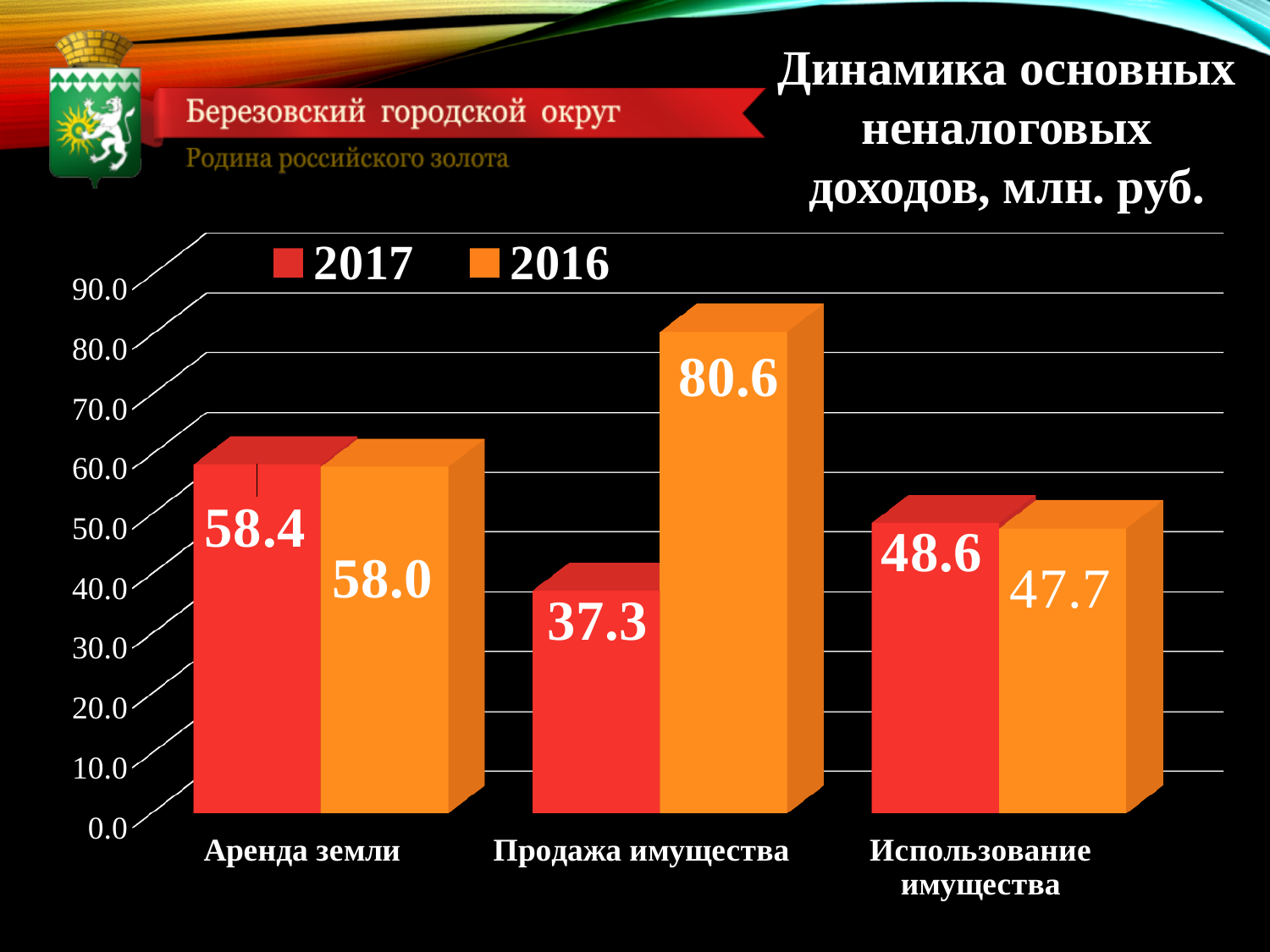
Which category has the highest 2016 value? Продажа имущества What is the 2017 value for Продажа имущества? 37.3 Which is larger for Использование имущества: the 2017 value or the 2016 value? 2017 How many categories are shown on the x axis? 3 What is the 2016 value for Использование имущества? 47.7 How many series does the legend list? 2 What is the 2016 value for Продажа имущества? 80.6 What is the difference between the 2016 and 2017 values for Продажа имущества? 43.3 What is the 2017 value for Аренда земли? 58.4 Is the 2016 value for Продажа имущества greater or less than 80.0? greater Which category has the lowest 2017 value? Продажа имущества What kind of chart is shown on the slide? bar chart